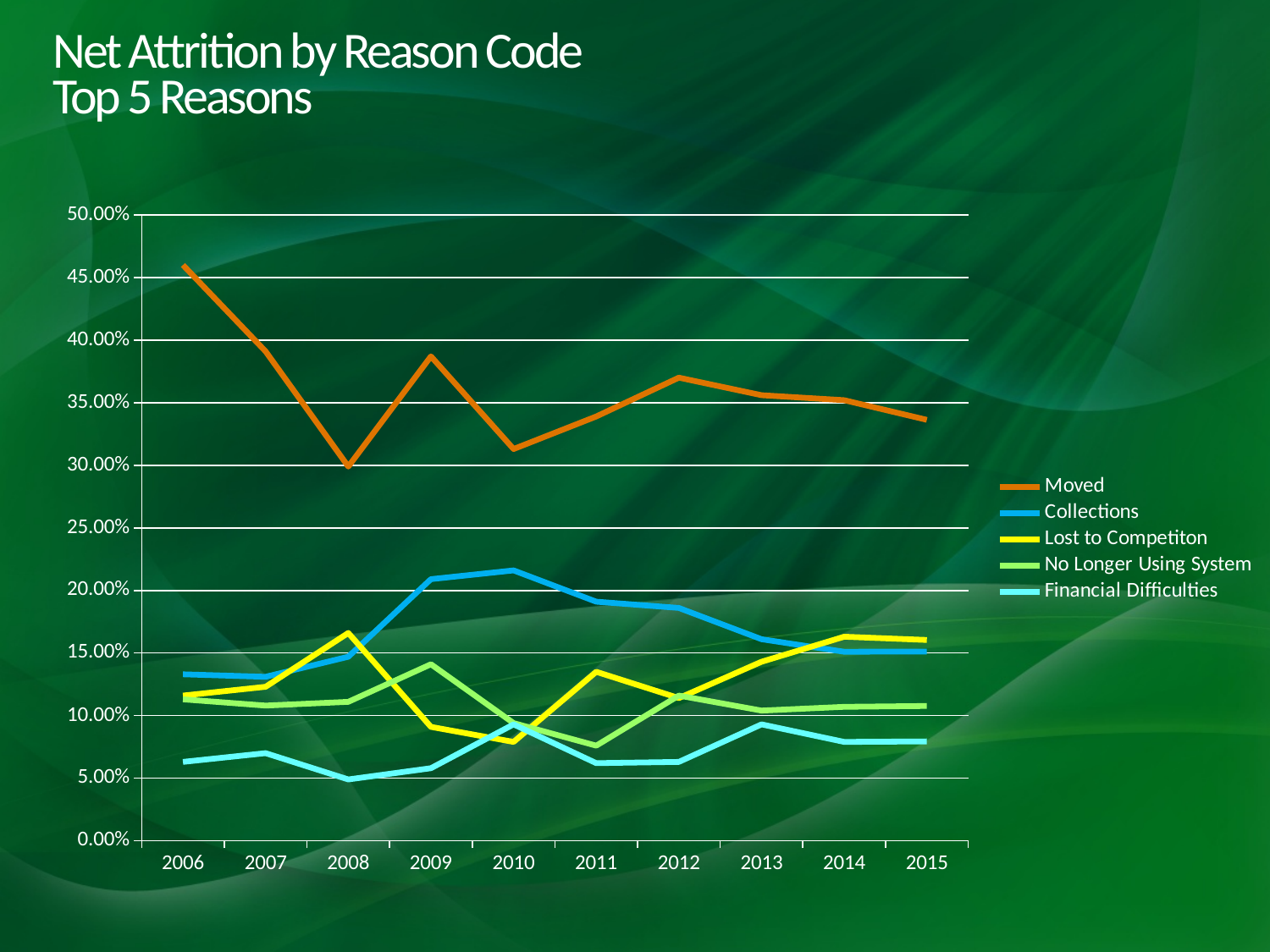
Is the value for Collections in 2010 greater or less than 20.00%? greater How many years are shown on the x axis? 10 Which reason code has the highest net attrition across all years shown? Moved How many series does the legend list? 5 Is the value for Moved in 2015 greater or less than 35.00%? less Is the value for Moved in 2006 greater or less than 40.00%? greater Does the value for Collections rise or fall from 2010 to 2015? fall Which is larger in 2009: No Longer Using System or Financial Difficulties? No Longer Using System What kind of chart is shown on the slide? line chart In which year is the value for Moved highest? 2006 In which year is the value for Collections highest? 2010 In which year is the value for Moved lowest? 2008